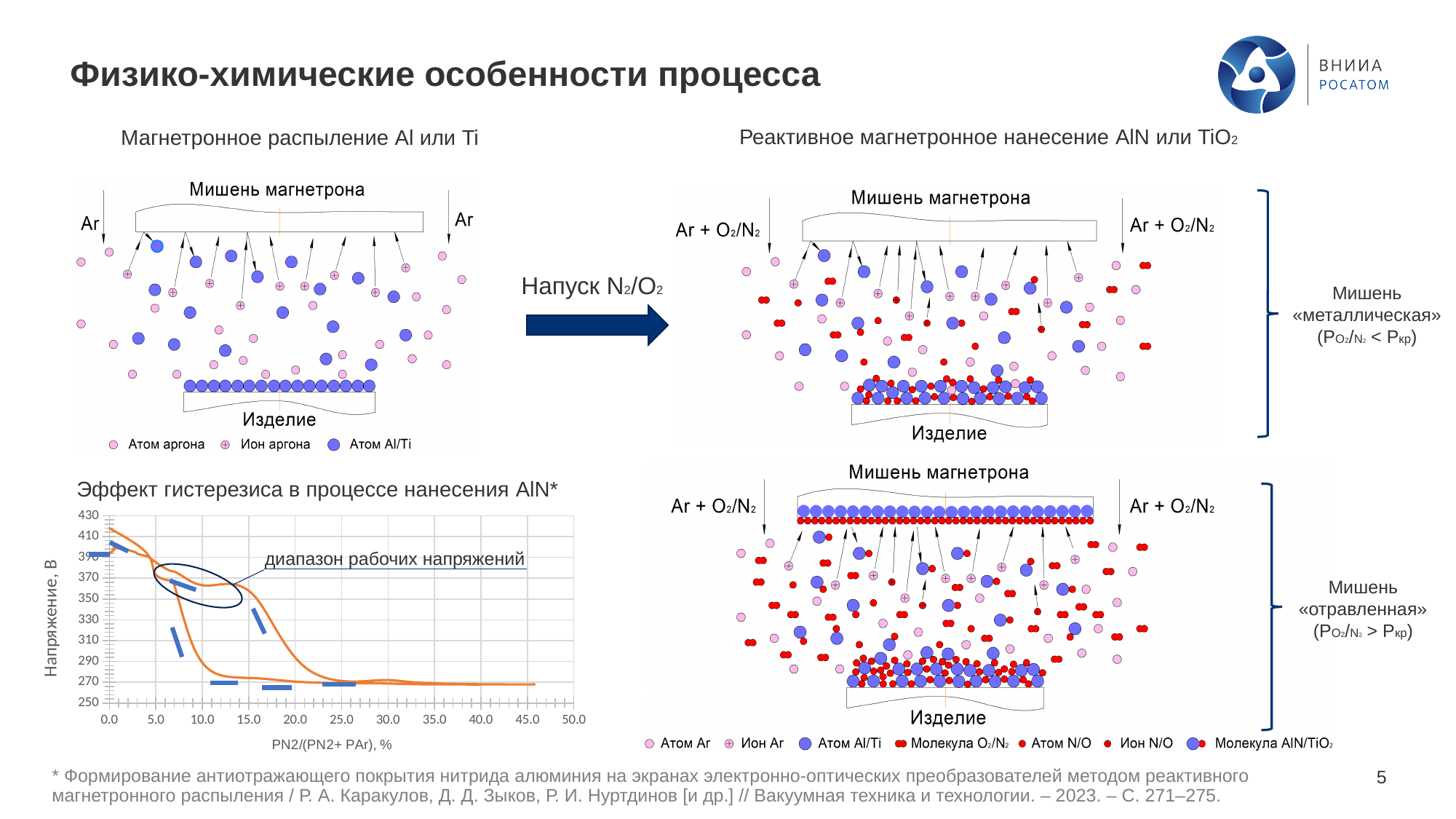
What is the label of the x axis of the hysteresis chart? PN2/(PN2+ PAr), % What kind of chart is shown under the title "Эффект гистерезиса в процессе нанесения AlN*"? line chart In the hysteresis chart, is the voltage at PN2/(PN2+PAr) = 40.0 % greater or less than 290 В? less What is the label of the y axis of the hysteresis chart? Напряжение, В In the hysteresis chart, do the voltage values generally rise or fall as PN2/(PN2+PAr) increases? fall In the hysteresis chart, is the voltage at PN2/(PN2+PAr) = 30.0 % greater or less than 310 В? less In the hysteresis chart, is the voltage at PN2/(PN2+PAr) = 0.0 % greater or less than 390 В? greater